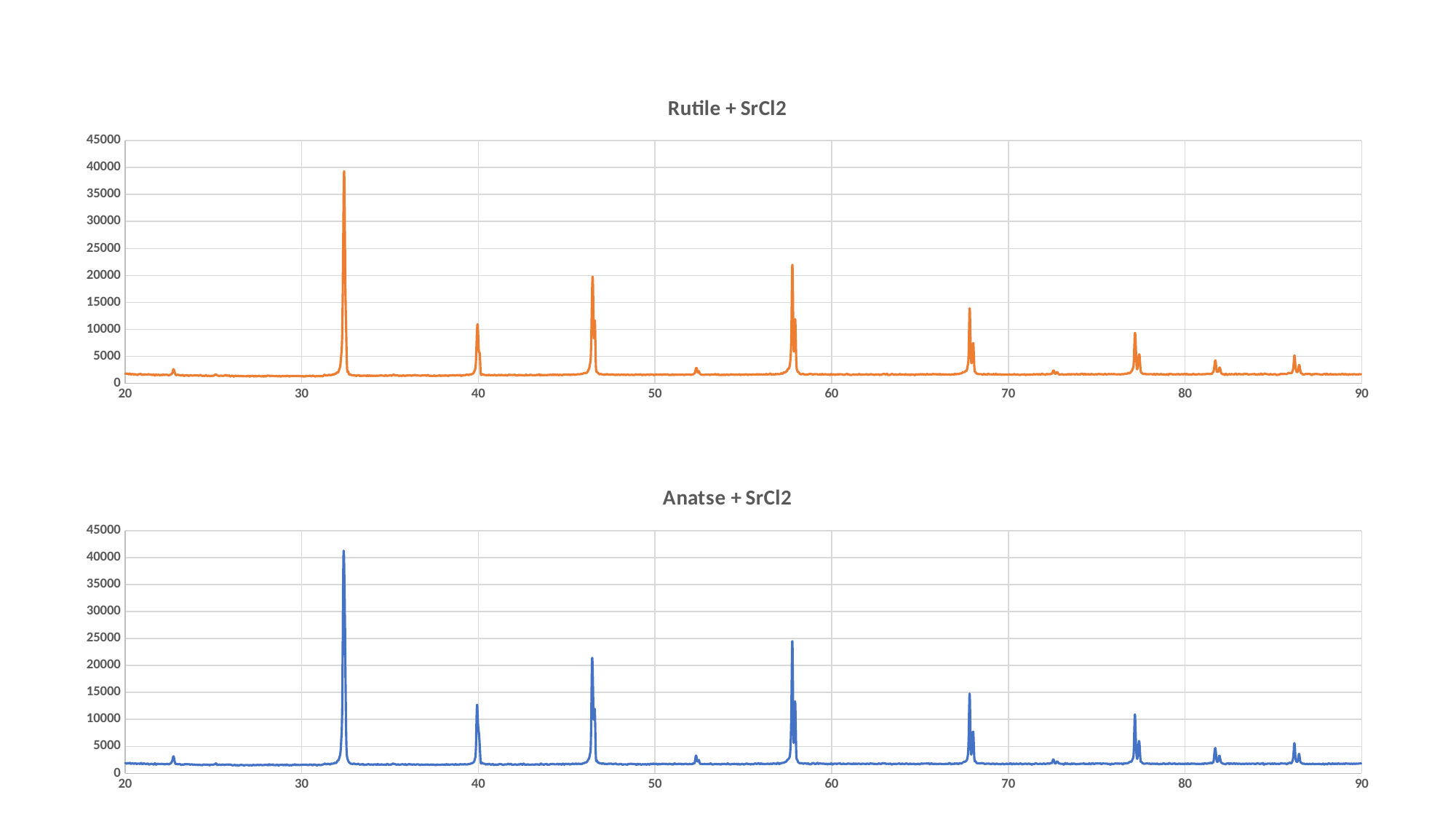
In the "Anatse + SrCl2" chart, between which two labelled x-axis ticks does the tallest peak occur? between 30 and 40 In the "Rutile + SrCl2" chart, is the height of the tallest peak greater or less than 35000? greater In the "Anatse + SrCl2" chart, is the peak between x = 40 and x = 50 greater or less than 15000? greater What kind of chart is the "Rutile + SrCl2" chart? line chart In the "Anatse + SrCl2" chart, is the height of the tallest peak greater or less than 35000? greater What is the title of the lower chart on the slide? Anatse + SrCl2 In the "Rutile + SrCl2" chart, between which two labelled x-axis ticks does the tallest peak occur? between 30 and 40 In the "Rutile + SrCl2" chart, what colour is the plotted line? orange